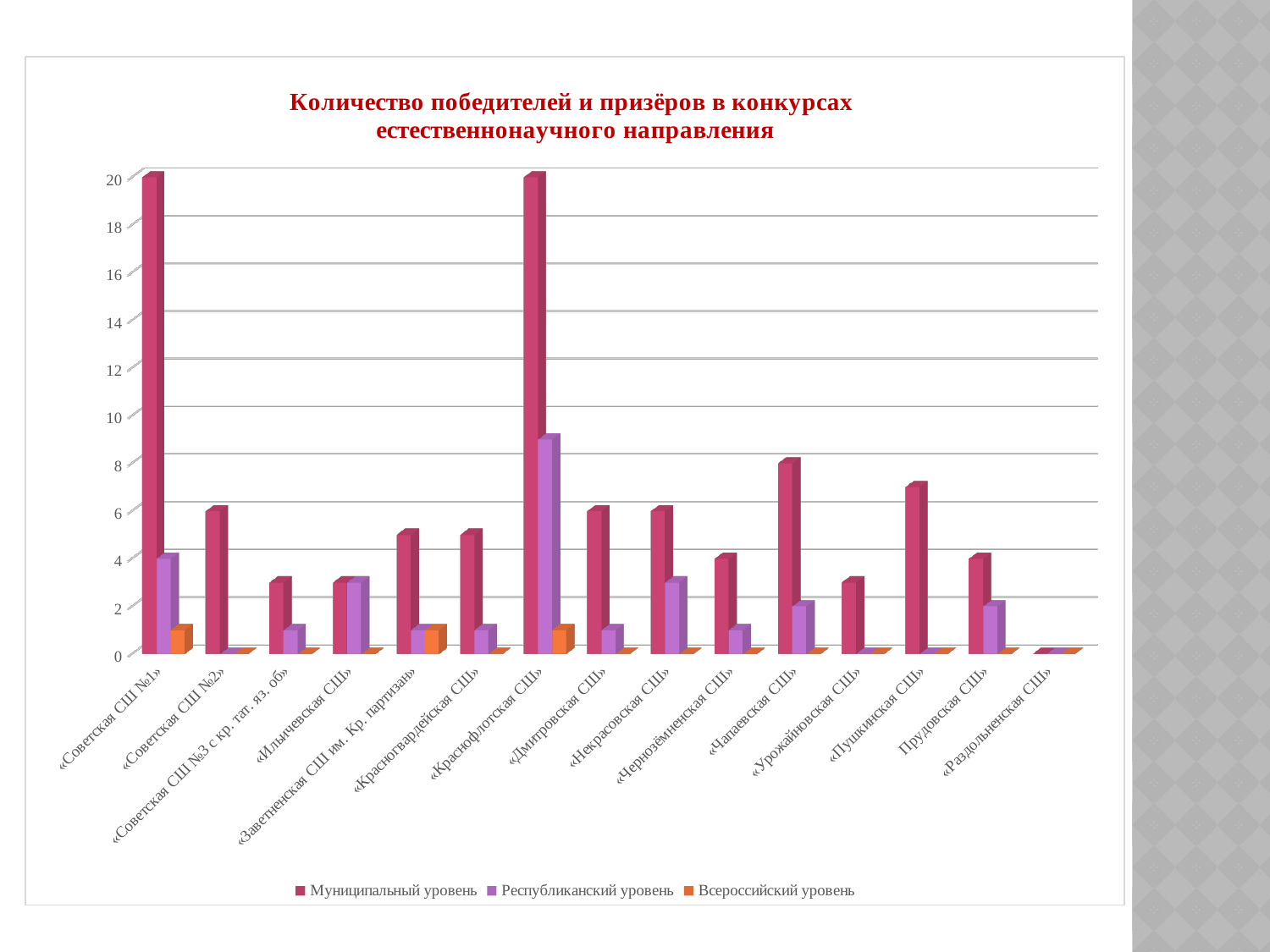
Is the Муниципальный уровень value for «Ильичевская СШ» greater or less than 4? less How many series does the legend list? 3 Which is larger: the Муниципальный уровень value for «Чапаевская СШ» or for «Дмитровская СШ»? «Чапаевская СШ» What kind of chart is shown on the slide? bar chart Which school has the highest value for Республиканский уровень? «Краснофлотская СШ» How many schools (categories) are shown on the x axis? 15 Is the Муниципальный уровень value for «Советская СШ №2» greater or less than 4? greater Is the Республиканский уровень value for «Краснофлотская СШ» greater or less than 6? greater Which is larger: the Республиканский уровень value for «Советская СШ №1» or for «Прудовская СШ»? «Советская СШ №1» Which school has the lowest value for Муниципальный уровень? «Раздольненская СШ» What is the title of the chart? Количество победителей и призёров в конкурсах естественнонаучного направления